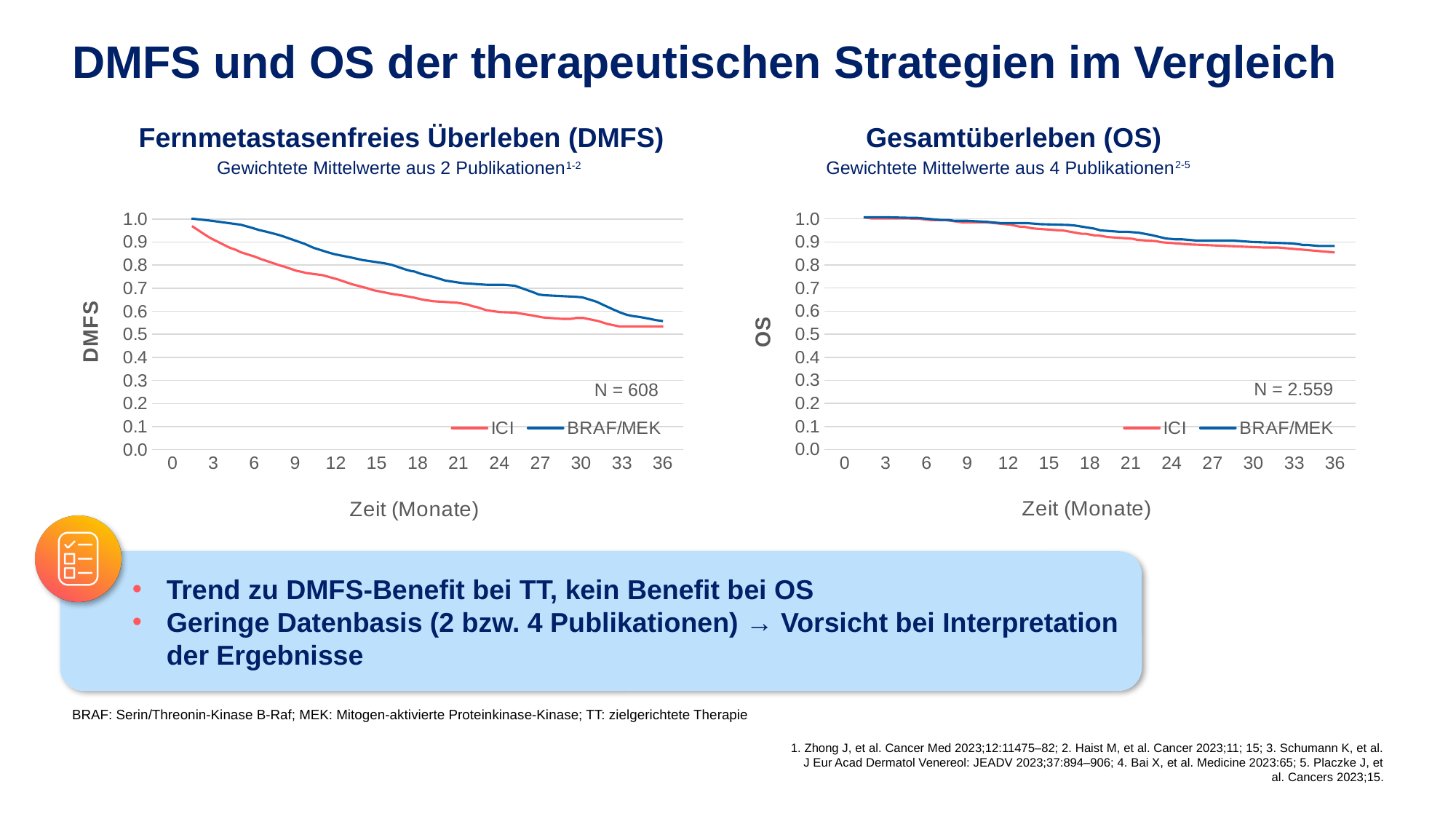
What kind of chart is the Fernmetastasenfreies Überleben (DMFS) chart? line chart In the DMFS chart, is the ICI value at 36 months greater or less than 0.6? less In the DMFS chart, do the values rise or fall as time (Monate) increases? fall In the DMFS chart, is the ICI value at 12 months greater or less than 0.8? less In the DMFS chart, which series is higher at 24 months, ICI or BRAF/MEK? BRAF/MEK What N value is printed on the DMFS chart? N = 608 In the OS chart, is the BRAF/MEK value at 12 months greater or less than 0.9? greater How many series does the legend of the Gesamtüberleben (OS) chart list? 2 How many tick labels are shown on the x axis of the OS chart? 13 What N value is printed on the OS chart? N = 2.559